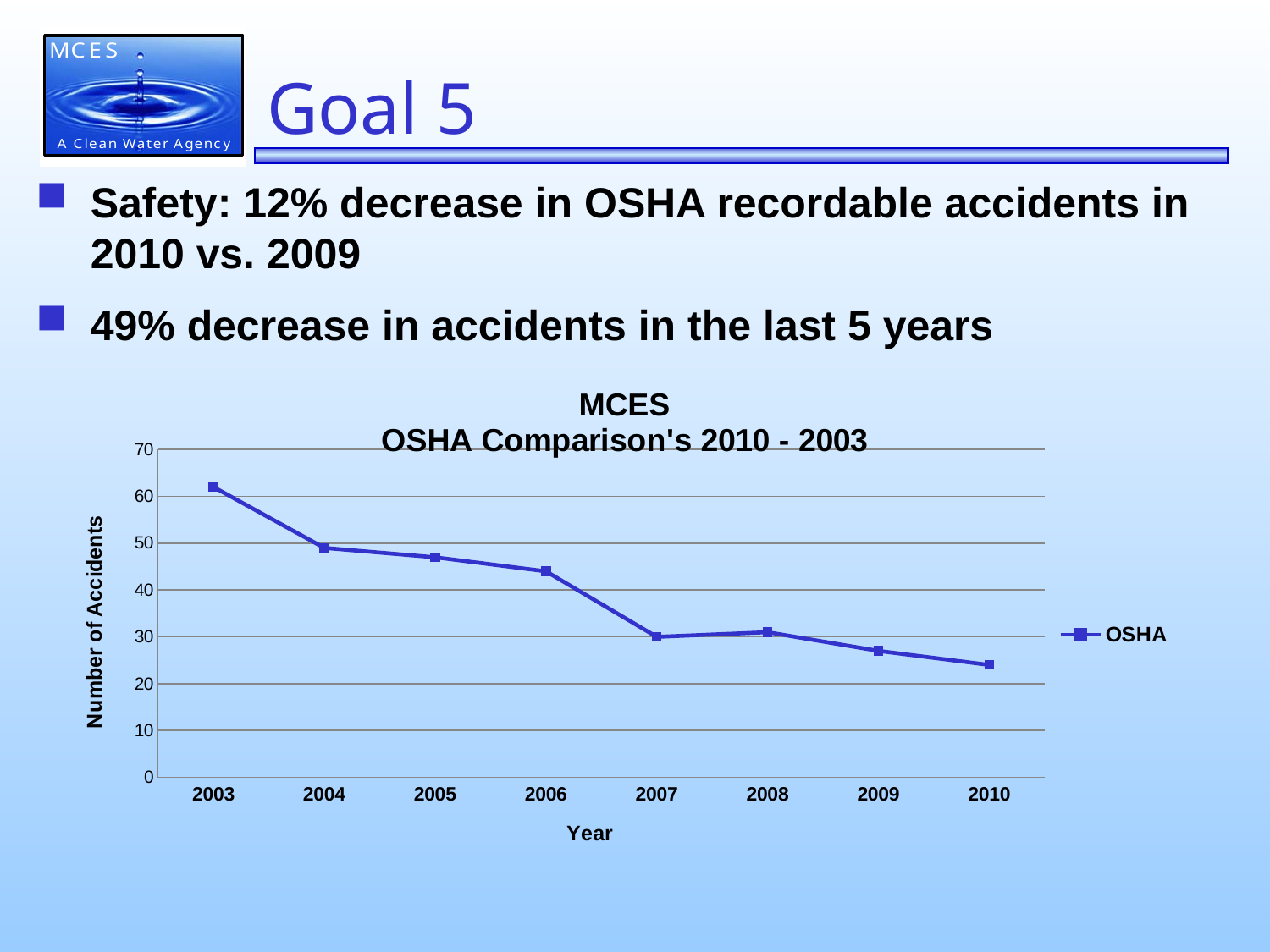
How many series does the legend list? 1 Is the value for 2003 greater or less than 60? greater Which year has more accidents, 2006 or 2007? 2006 Which year has the highest number of accidents? 2003 How many years are plotted on the x axis? 8 What kind of chart is shown on the slide? Line chart Is the value for 2010 greater or less than 30? less Is the value for 2005 greater or less than 50? less Do the values generally rise or fall from 2003 to 2010? Fall Which year has the lowest number of accidents? 2010